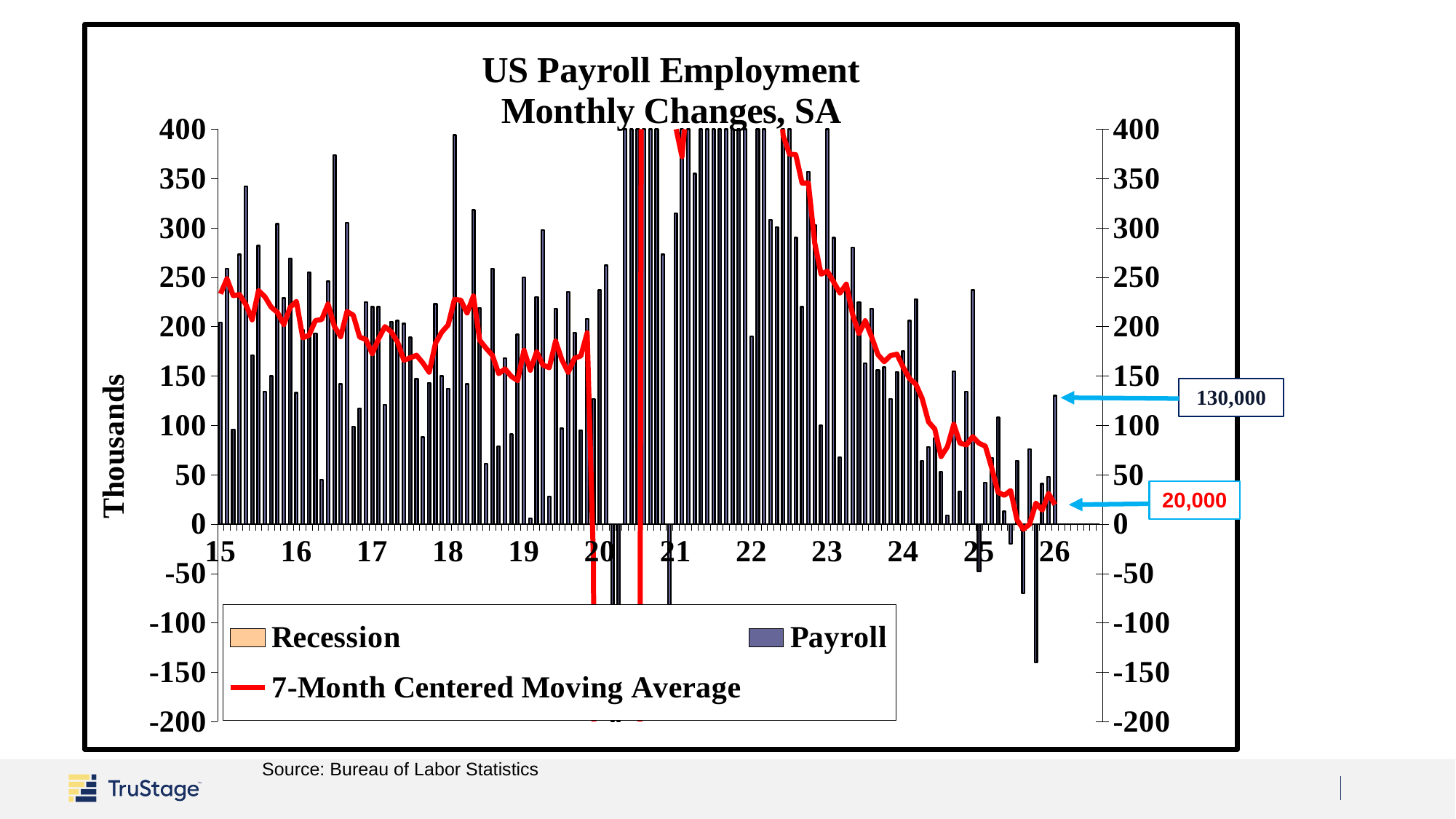
Does the 7-Month Centered Moving Average rise or fall between 22 and 26? Fall What value does the annotation give for the most recent Payroll bar? 130,000 What is the title of the chart? US Payroll Employment Monthly Changes, SA Is the 7-Month Centered Moving Average at the start of 15 greater or less than 200? greater Which is higher, the 7-Month Centered Moving Average in 22 or in 25? 22 By how much does the annotated latest Payroll value (130,000) exceed the annotated moving average value (20,000)? 110,000 What value does the annotation give for the latest point of the 7-Month Centered Moving Average? 20,000 How many entries does the chart's legend list? 3 How many year labels are shown on the x axis? 12 What kind of chart is this? Bar chart with a line Is the lowest Payroll bar near 25 greater or less than -100? less What is the label on the vertical axis? Thousands